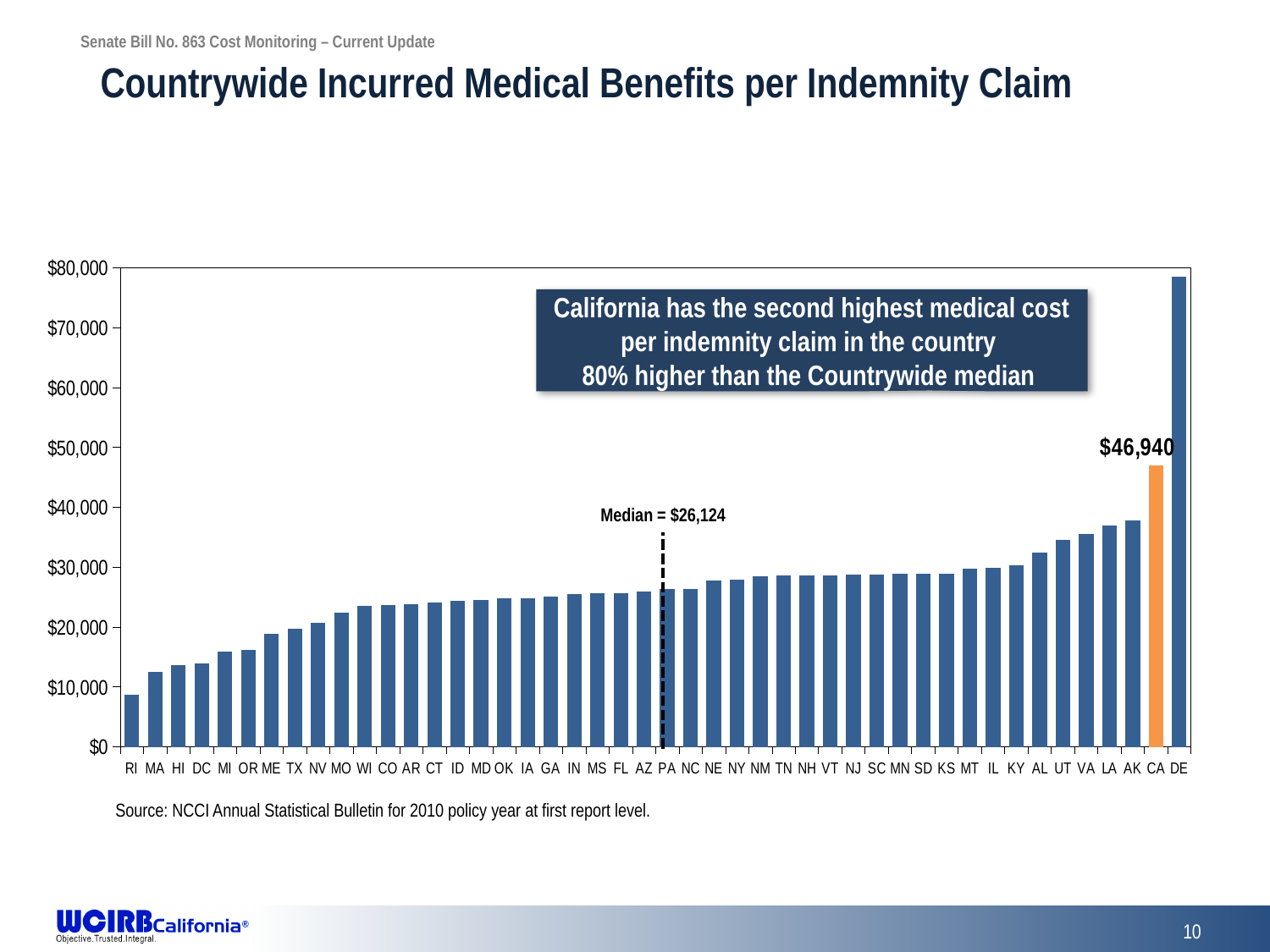
How many states or jurisdictions are plotted on the chart? 46 Which state's bar is highlighted in orange? CA Which has a higher value, CA or AK? CA What kind of chart is shown on the slide? Bar chart Is the value for AL greater or less than $30,000? greater Is the value for DE greater or less than $70,000? greater What is the Countrywide median value marked on the chart? $26,124 Do the values rise or fall moving from left to right along the x axis? Rise Which state has the lowest incurred medical benefits per indemnity claim? RI Is the value for RI greater or less than $10,000? less What is the incurred medical benefits per indemnity claim value shown for CA? $46,940 Which state has the highest incurred medical benefits per indemnity claim? DE